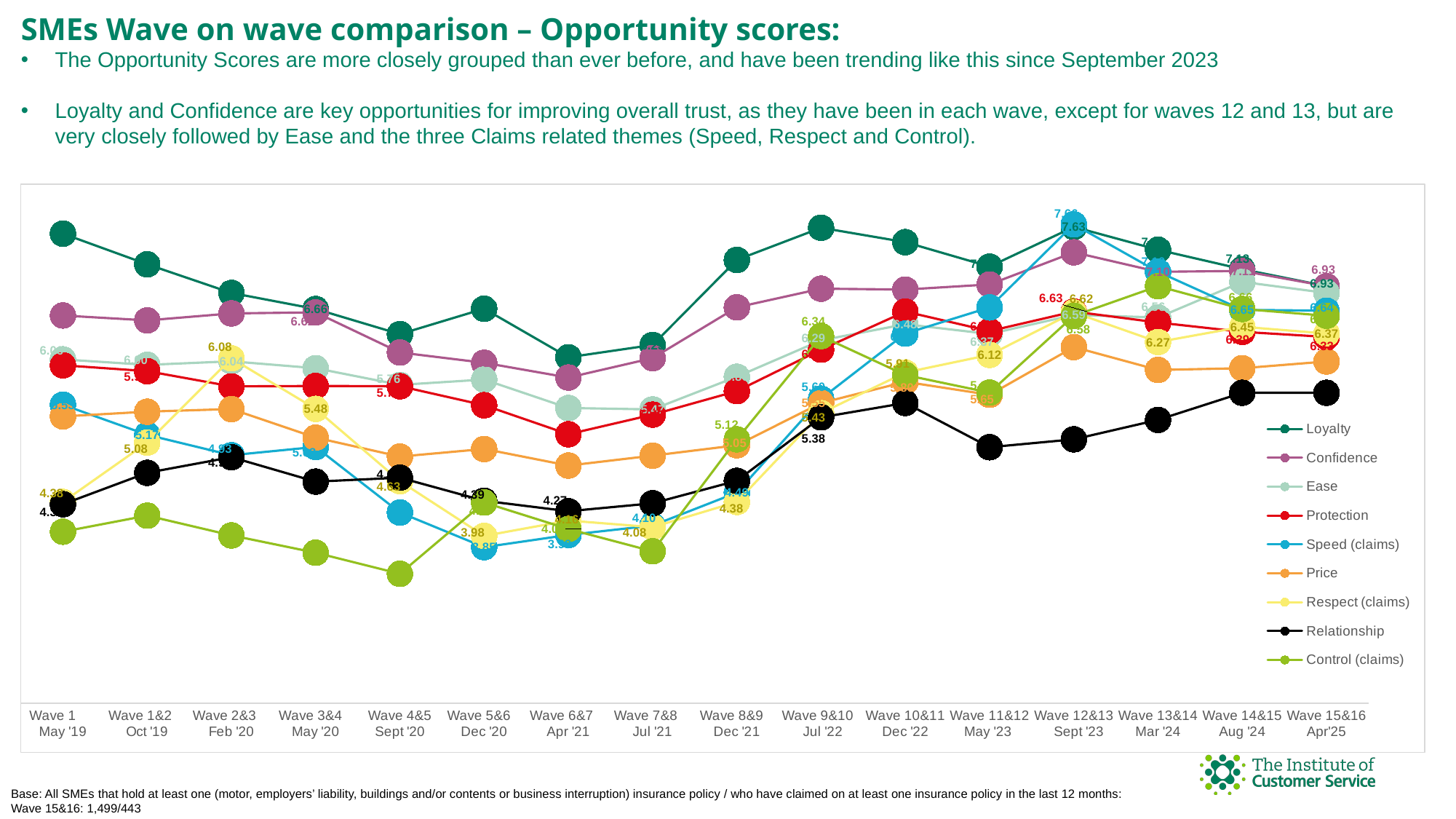
How many series does the legend list? 9 How many waves are shown along the x axis? 16 What is the Confidence score at Wave 15&16 (Apr '25)? 6.93 Which is the first series listed in the legend? Loyalty What is the Speed (claims) score at Wave 12&13 (Sept '23)? 7.66 What is the Respect (claims) score at Wave 2&3 (Feb '20)? 6.08 Does the Loyalty score rise or fall from Wave 1 to Wave 4&5? Fall What type of chart is shown on the slide? Line chart Which theme has the lowest Opportunity score at Wave 4&5 (Sept '20)? Control (claims) Which theme has the highest Opportunity score at Wave 1 (May '19)? Loyalty What is the Relationship score at Wave 6&7 (Apr '21)? 4.27